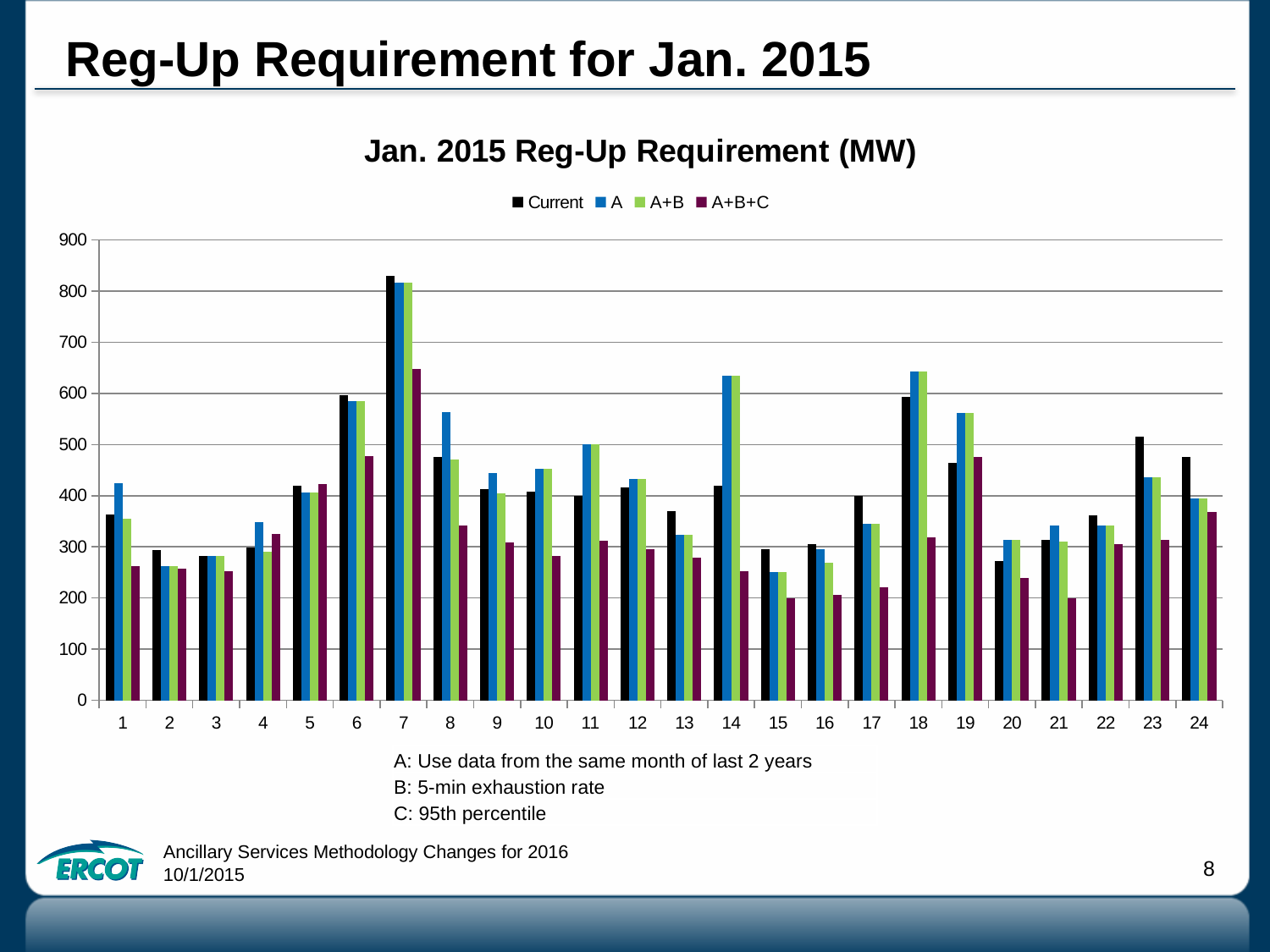
Is the A value at hour 14 greater or less than 600? greater For the Current series, which hour has the highest value? 7 Is the A+B+C value at hour 7 greater or less than 600? greater Does the Current series rise or fall from hour 4 to hour 7? rise Is the Current value at hour 20 greater or less than 300? less How many series does the legend list? 4 What is the title of the chart? Jan. 2015 Reg-Up Requirement (MW) How many hour categories are shown on the x axis? 24 Which series is shown in black in the legend? Current At hour 14, which is larger: the A value or the A+B+C value? A What type of chart is shown on the slide? bar chart